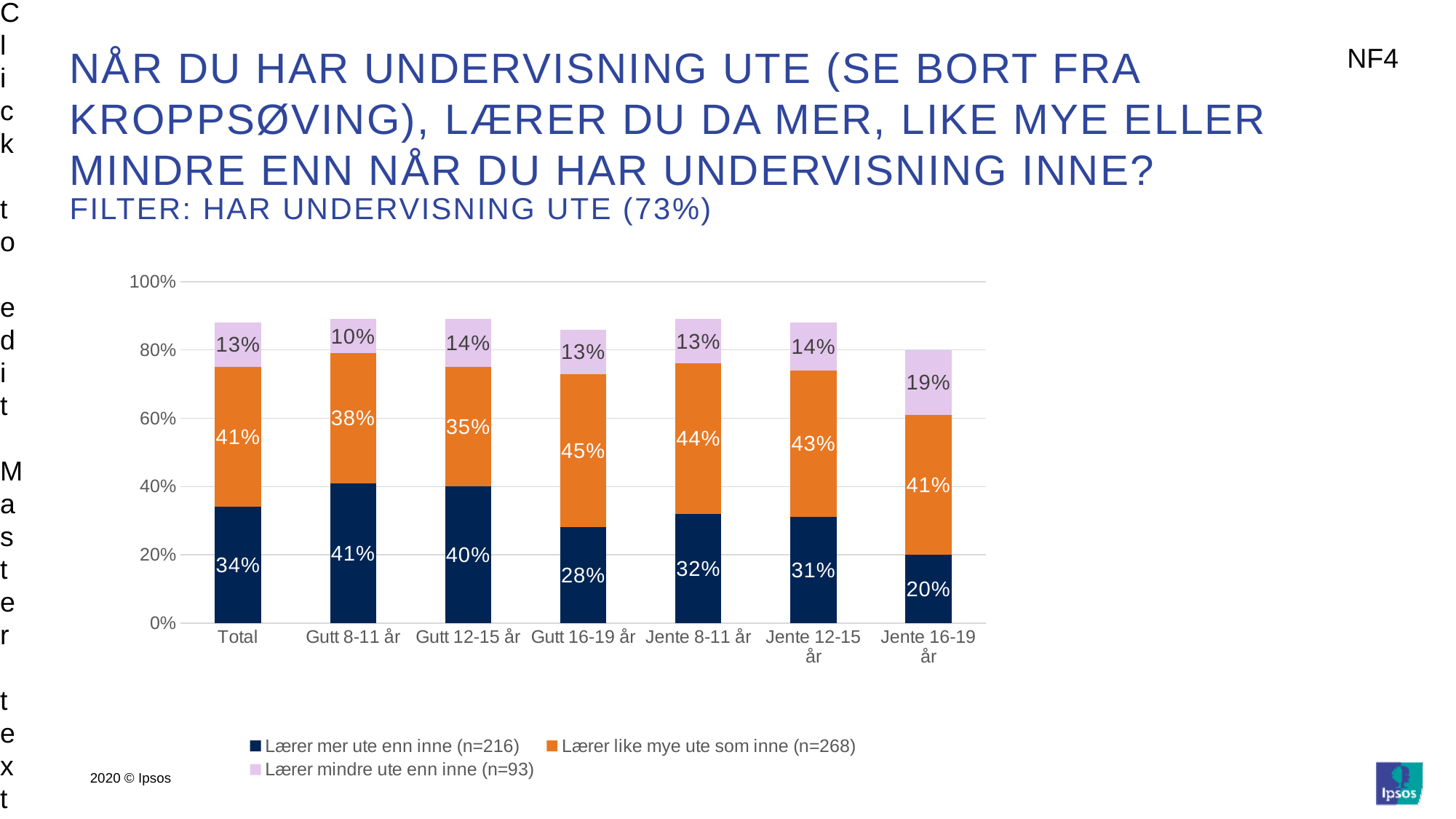
What is the difference between the "Lærer mer ute enn inne" values for Gutt 8-11 år and Jente 16-19 år? 21 percentage points Which category has the lowest value for "Lærer mer ute enn inne"? Jente 16-19 år What kind of chart is shown on the slide? Stacked bar chart What is the total of the three stacked segments for Jente 16-19 år? 80% How many categories are shown on the x axis? 7 How many series does the legend list? 3 Which category has the lowest value for "Lærer mindre ute enn inne"? Gutt 8-11 år Which category has the highest value for "Lærer mer ute enn inne"? Gutt 8-11 år Which is larger: the "Lærer like mye ute som inne" value for Gutt 16-19 år or for Gutt 12-15 år? Gutt 16-19 år What percentage of Gutt 16-19 år answered "Lærer mer ute enn inne"? 28% What is the value for "Lærer mindre ute enn inne" in the Jente 16-19 år bar? 19% What is the "Lærer like mye ute som inne" value for Total? 41%